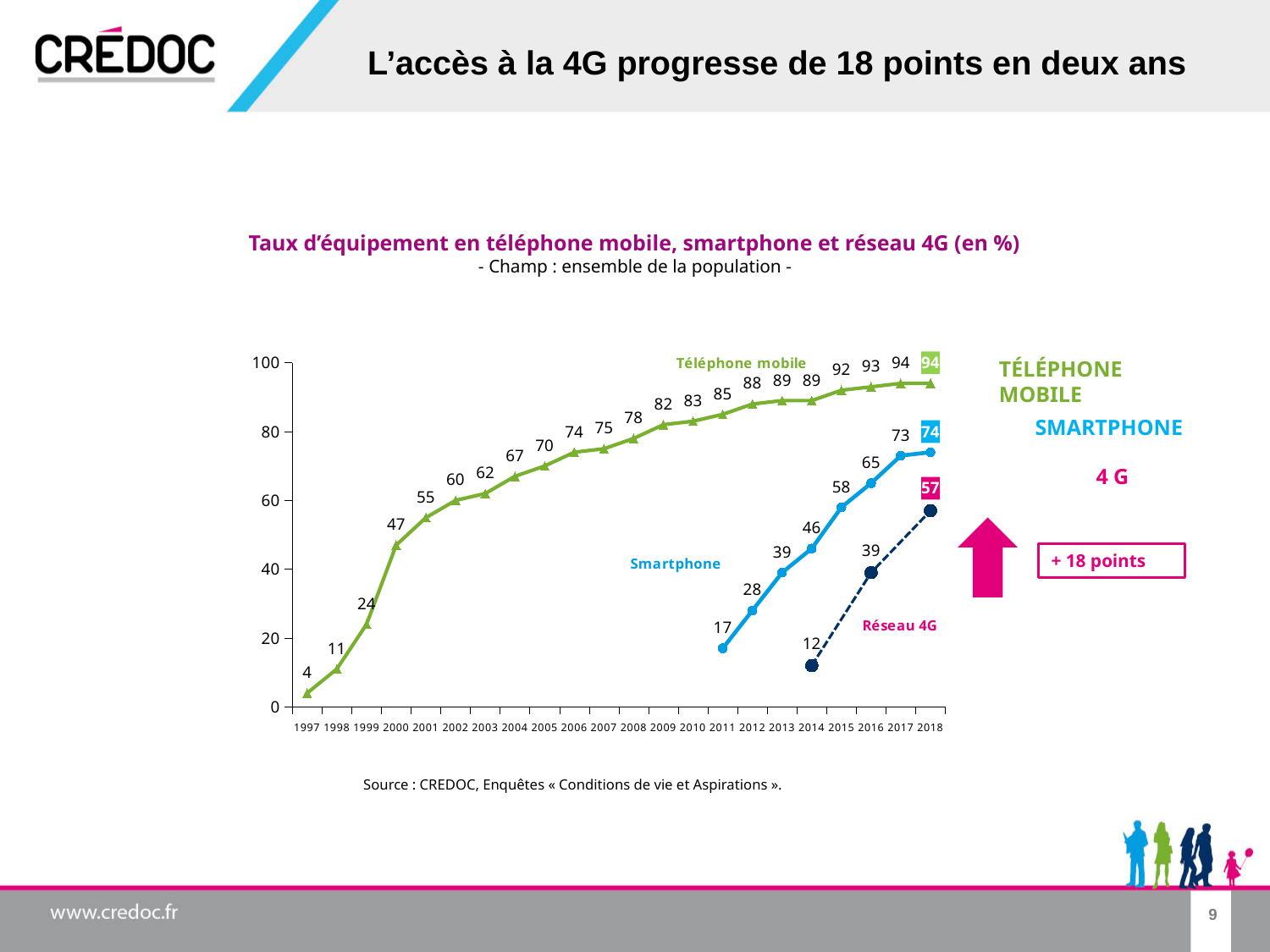
How many series are plotted on the chart? 3 What kind of chart is shown on the slide? line chart What is the difference between Téléphone mobile and Smartphone in 2018? 20 What is the value for Téléphone mobile in 2000? 47 By how many points did Réseau 4G increase between 2016 and 2018? 18 In 2016, which is larger: Smartphone or Réseau 4G? Smartphone What is the value for Réseau 4G in 2014? 12 In which year is the Téléphone mobile value lowest? 1997 Does the Smartphone series rise or fall from 2011 to 2018? rise What is the value for Téléphone mobile in 2018? 94 What is the value for Smartphone in 2011? 17